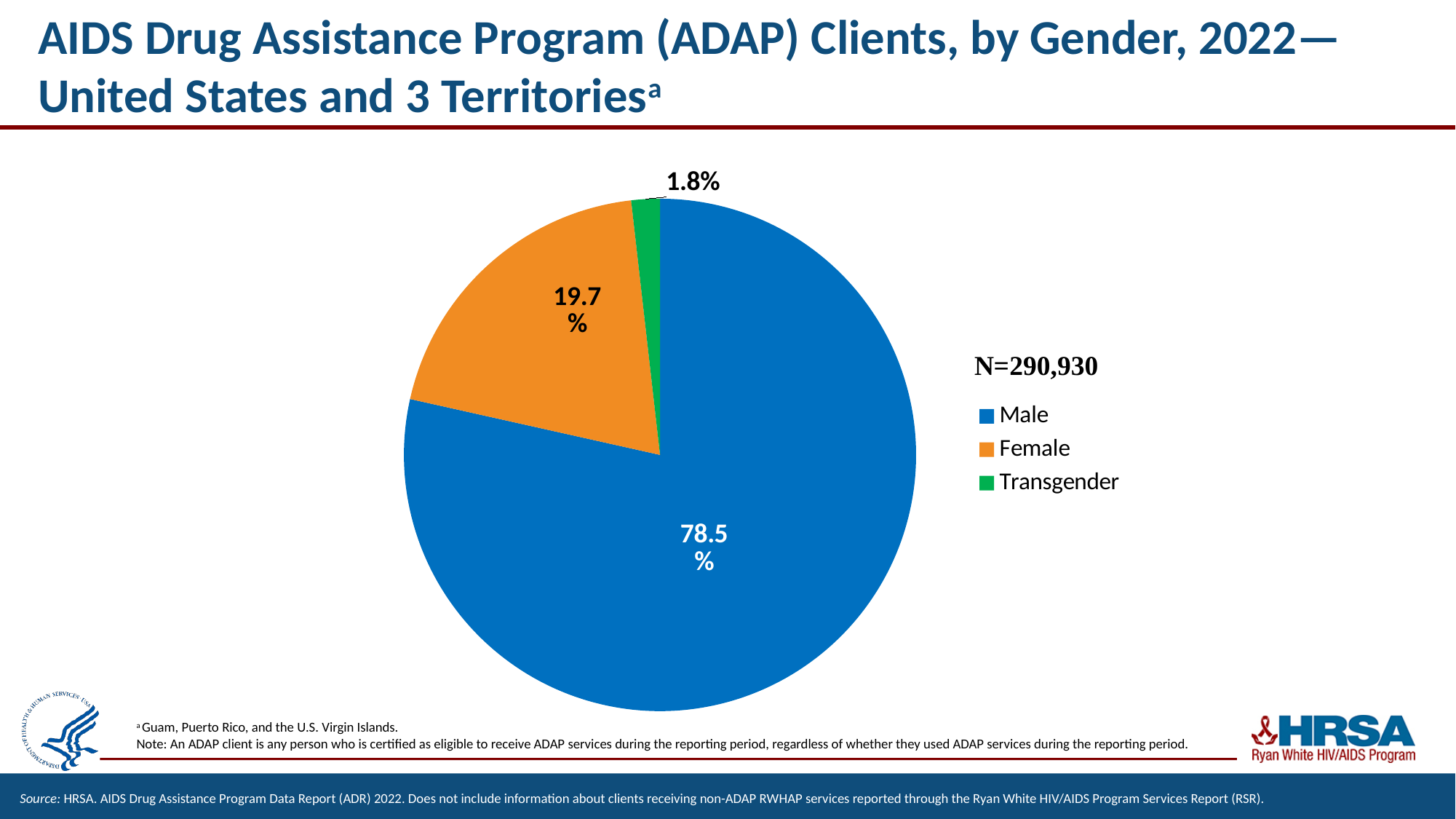
What is the total number of ADAP clients (N) shown on the slide? 290,930 What percentage of ADAP clients are Male? 78.5% What percentage of ADAP clients are Female? 19.7% Which gender category has the smallest share of ADAP clients? Transgender How many gender categories are shown in the pie chart? 3 What colour represents the Female category in the pie chart? Orange Which gender category has the largest share of ADAP clients? Male What is the difference in percentage points between the Male and Female shares? 58.8 Which is larger, the Female share or the Transgender share? Female What kind of chart is shown on the slide? Pie chart What is the difference in percentage points between the Female and Transgender shares? 17.9 What percentage of ADAP clients are Transgender? 1.8%